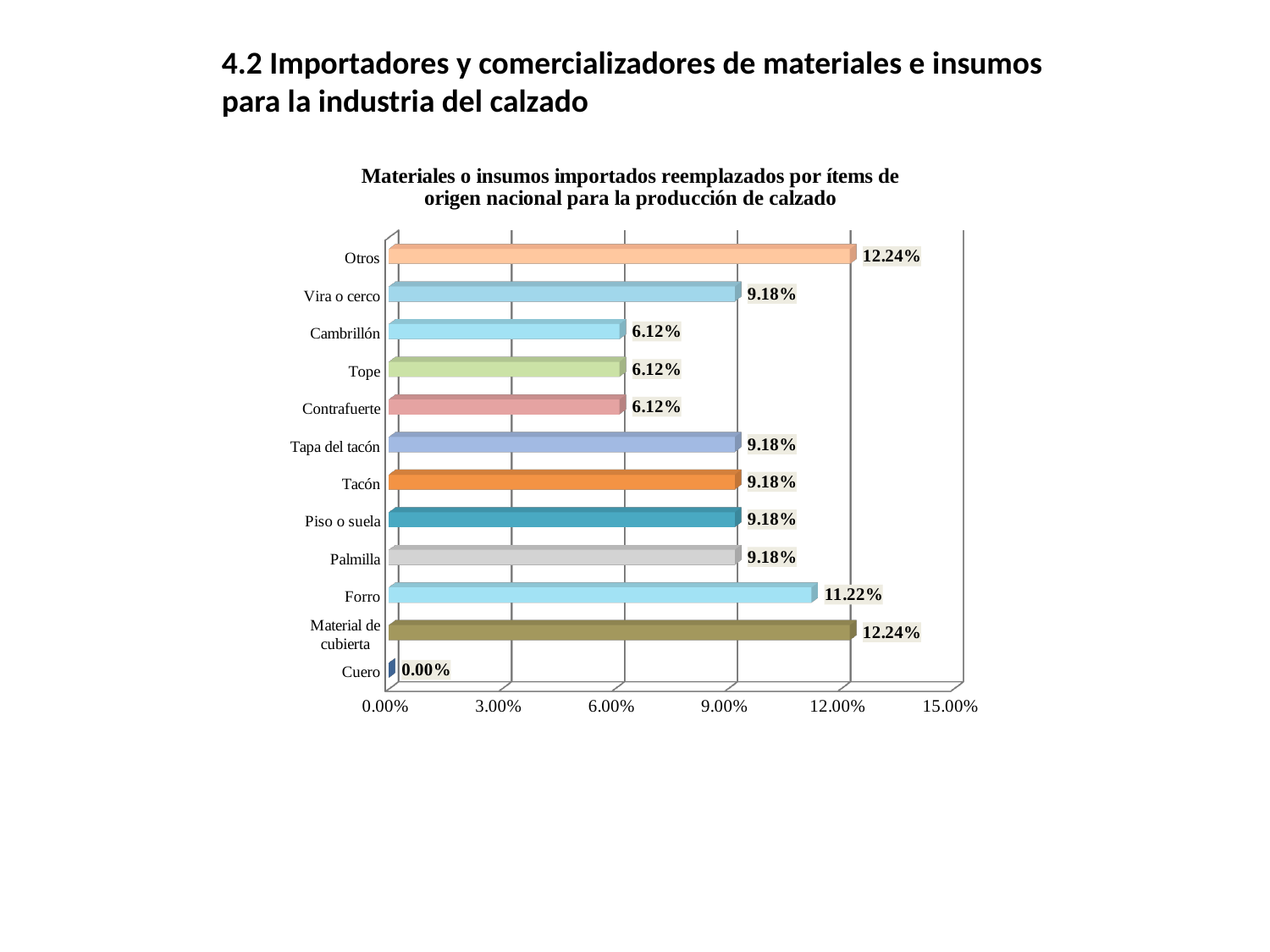
How many categories are shown in the chart? 12 Which category has the lowest value? Cuero What is the difference between the values for Otros and Forro? 1.02% What is the value for Material de cubierta? 12.24% What is the difference between the values for Palmilla and Tope? 3.06% What is the value for Cuero? 0.00% What kind of chart is shown on the slide? Bar chart What is the value for Forro? 11.22% Is the value for Tacón greater or less than 6.00%? greater What is the title of the chart? Materiales o insumos importados reemplazados por ítems de origen nacional para la producción de calzado Which is larger, the value for Forro or the value for Vira o cerco? Forro What is the value for Cambrillón? 6.12%